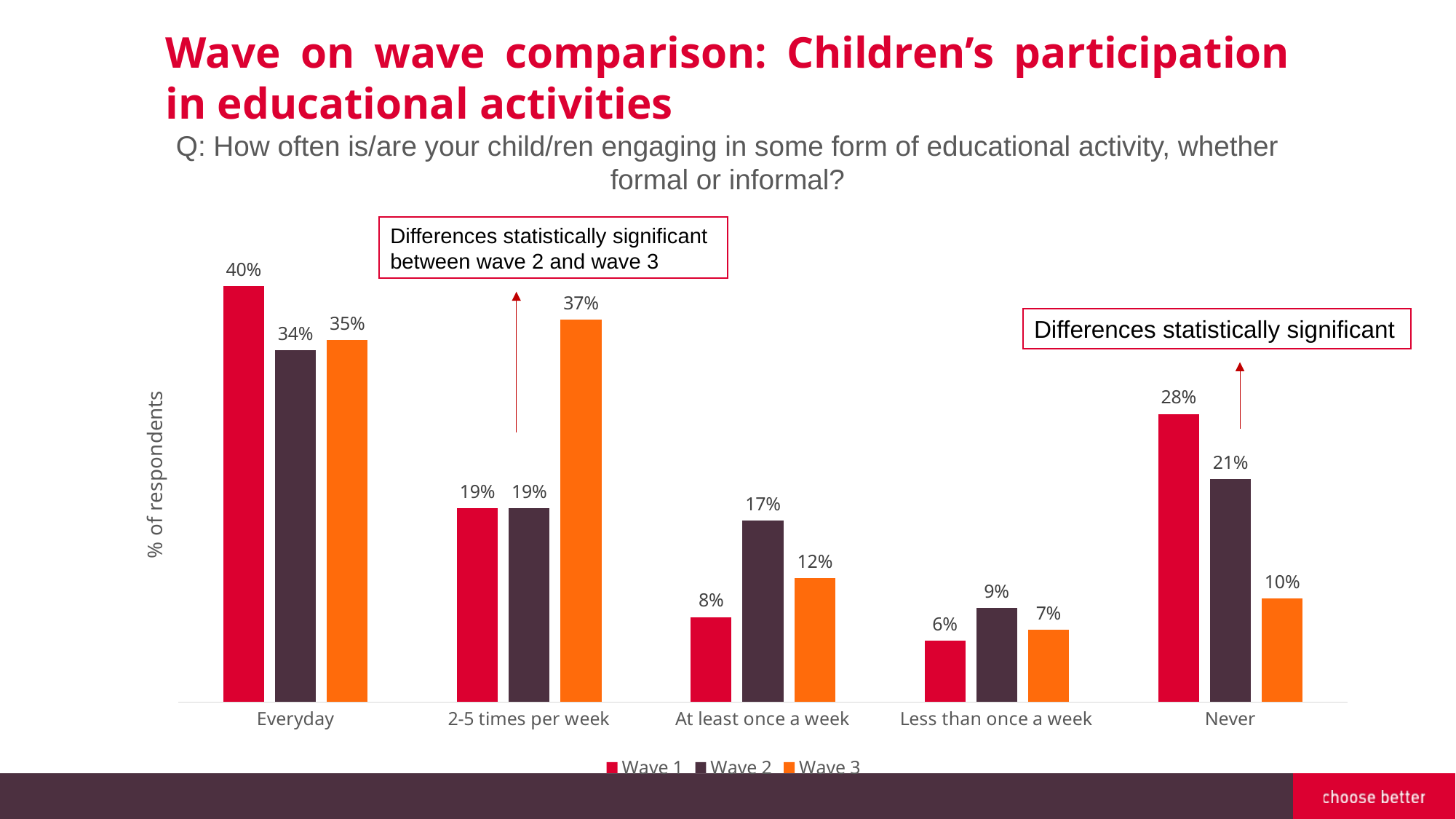
What is the label on the vertical axis? % of respondents Which category has the lowest Wave 3 value? Less than once a week Which is larger for At least once a week: Wave 2 or Wave 3? Wave 2 What is the Wave 3 value for Never? 10% What kind of chart is shown on the slide? Bar chart What is the Wave 2 value for At least once a week? 17% What is the Wave 3 value for 2-5 times per week? 37% How many categories are shown on the x axis? 5 Which category has the highest Wave 1 value? Everyday What is the Wave 1 value for Everyday? 40% How many series does the legend list? 3 What is the difference between the Wave 1 and Wave 3 values for Never? 18%